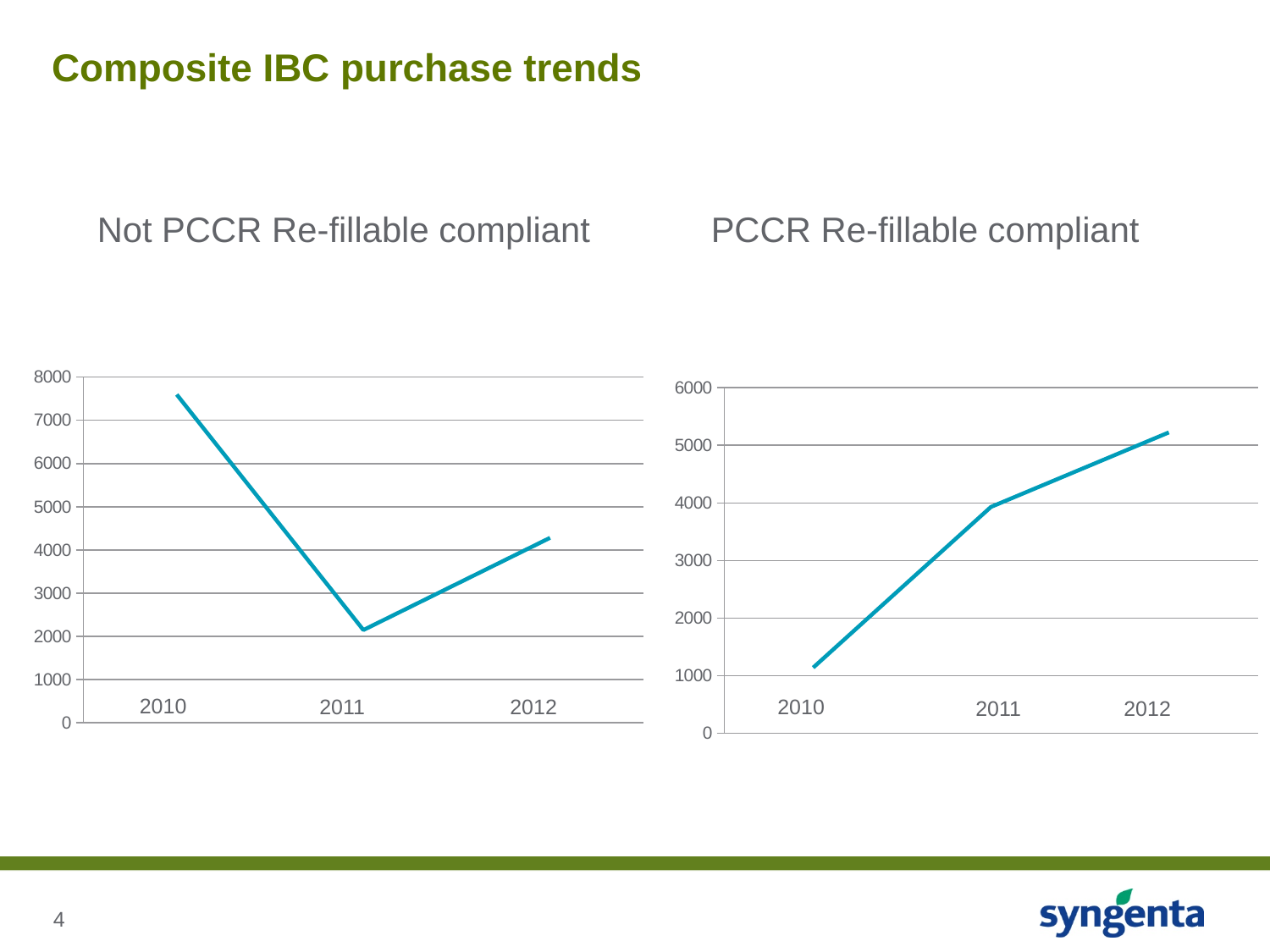
On the 'PCCR Re-fillable compliant' chart, which year has the highest value? 2012 On the 'PCCR Re-fillable compliant' chart, is the value for 2010 greater or less than 2000? less On the 'PCCR Re-fillable compliant' chart, is the value for 2012 greater or less than 5000? greater On the 'Not PCCR Re-fillable compliant' chart, is the value for 2011 greater or less than 3000? less What kind of chart is the 'Not PCCR Re-fillable compliant' chart? line chart On the 'PCCR Re-fillable compliant' chart, which year has the lowest value? 2010 On the 'Not PCCR Re-fillable compliant' chart, which year has the highest value? 2010 On the 'PCCR Re-fillable compliant' chart, do the values rise or fall from 2010 to 2012? rise On the 'Not PCCR Re-fillable compliant' chart, which year has the lowest value? 2011 On the 'Not PCCR Re-fillable compliant' chart, which is larger, the value for 2011 or the value for 2012? 2012 How many years are plotted on the 'PCCR Re-fillable compliant' chart? 3